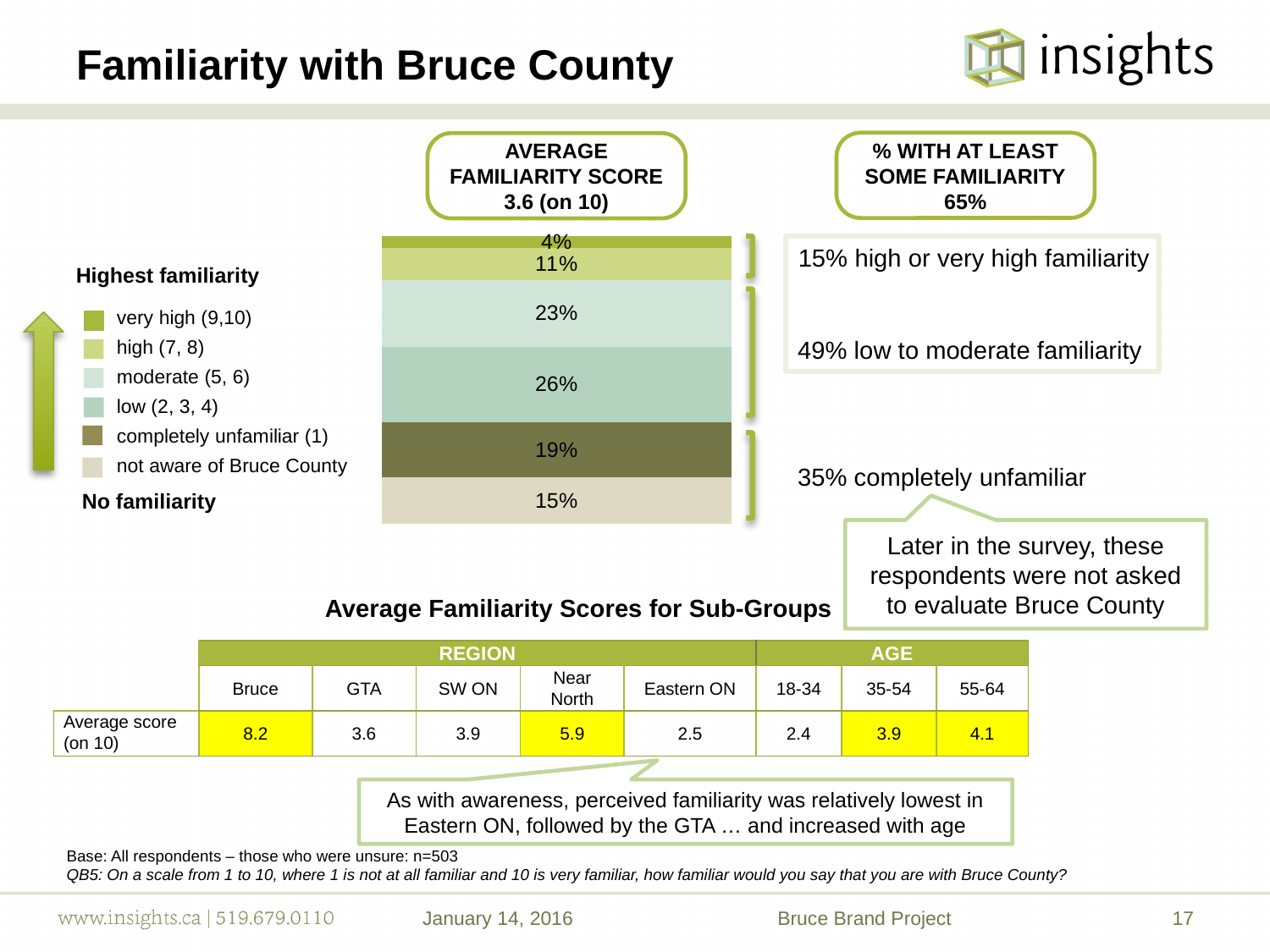
In the stacked bar chart, what percentage of respondents are not aware of Bruce County? 15% In the stacked bar chart, which segment is larger: completely unfamiliar (1) or not aware of Bruce County? completely unfamiliar (1) In the stacked bar chart, what percentage of respondents have moderate (5, 6) familiarity? 23% In the stacked bar chart, how many percentage points larger is the low (2, 3, 4) segment than the moderate (5, 6) segment? 3 percentage points How many segments make up the stacked bar in the familiarity chart? 6 In the stacked bar chart, what percentage of respondents have low (2, 3, 4) familiarity? 26% What kind of chart is used to show the familiarity breakdown on this slide? Stacked bar chart In the stacked bar chart, what percentage of respondents have very high (9,10) familiarity with Bruce County? 4% Which familiarity category has the smallest segment in the stacked bar chart? very high (9,10) In the stacked bar chart, what is the combined percentage of the moderate (5, 6) and low (2, 3, 4) segments? 49% Which familiarity category has the largest segment in the stacked bar chart? low (2, 3, 4) In the stacked bar chart, what percentage of respondents are completely unfamiliar (1) with Bruce County? 19%